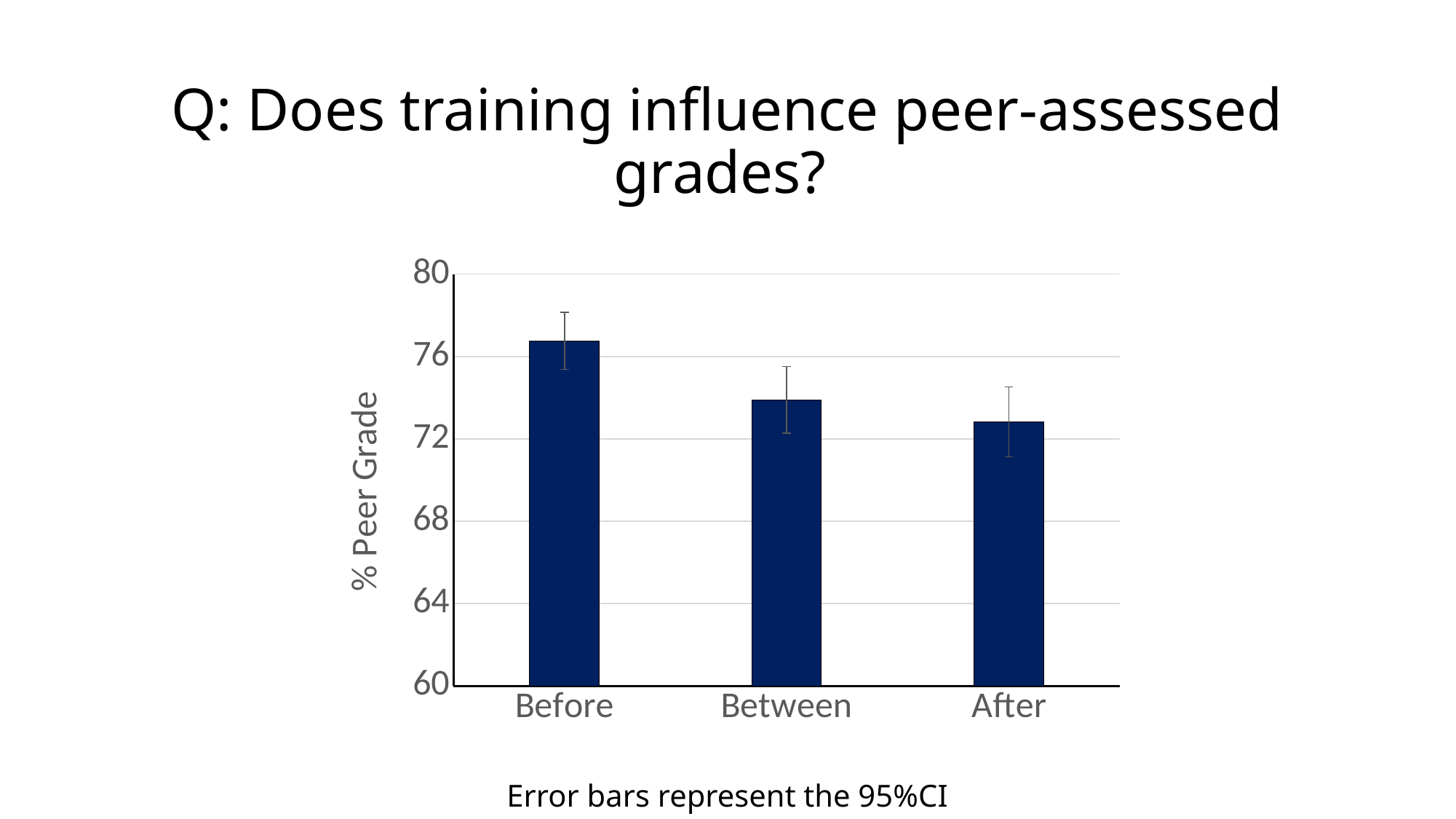
Which category has the lowest % Peer Grade? After Which is larger, the value for Before or the value for After? Before What kind of chart is shown on the slide? bar chart Is the value for Before greater or less than 80? less What is the label on the y axis of the chart? % Peer Grade Which category has the highest % Peer Grade? Before Do the values rise or fall from Before to After along the x axis? fall Is the value for Between greater or less than 72? greater Which is larger, the value for Before or the value for Between? Before How many categories are shown on the x axis of the chart? 3 Is the value for Between greater or less than 76? less